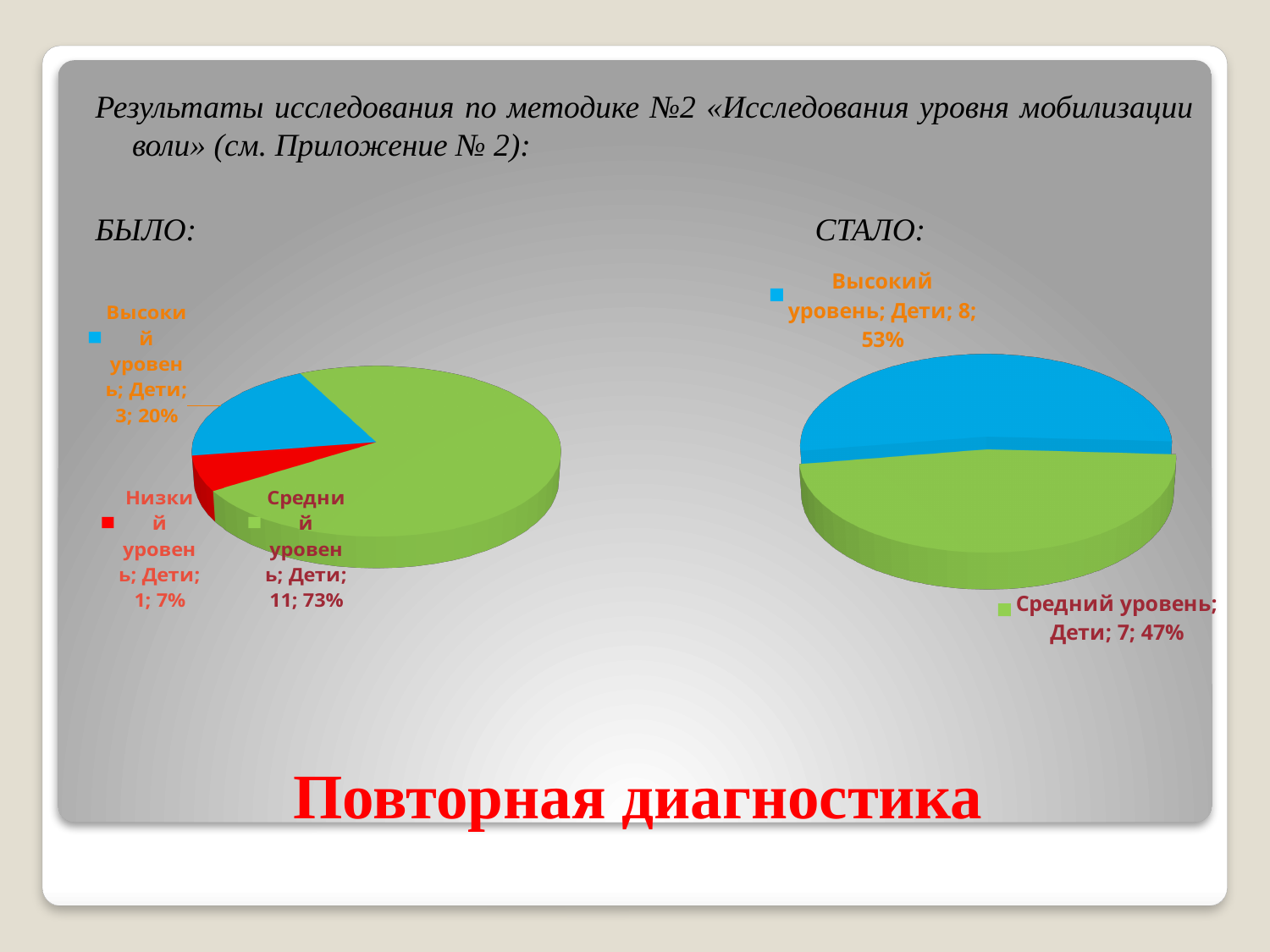
In the left pie chart (БЫЛО), which level has the largest slice? Средний уровень In the right pie chart (СТАЛО), how many children are at the Высокий уровень? 8 In the left pie chart (БЫЛО), how many slices are there? 3 What type of chart is used on the slide? Pie chart In the left pie chart (БЫЛО), what percentage share does Высокий уровень have? 20% In the left pie chart (БЫЛО), how many children are at the Средний уровень? 11 What is the difference in the number of children at Высокий уровень between the right chart (СТАЛО) and the left chart (БЫЛО)? 5 In the right pie chart (СТАЛО), which level has the larger slice? Высокий уровень In the left pie chart (БЫЛО), how many children are at the Низкий уровень? 1 In the right pie chart (СТАЛО), what percentage share does Средний уровень have? 47% In the left pie chart (БЫЛО), which level has the smallest slice? Низкий уровень In the right pie chart (СТАЛО), how many slices are there? 2